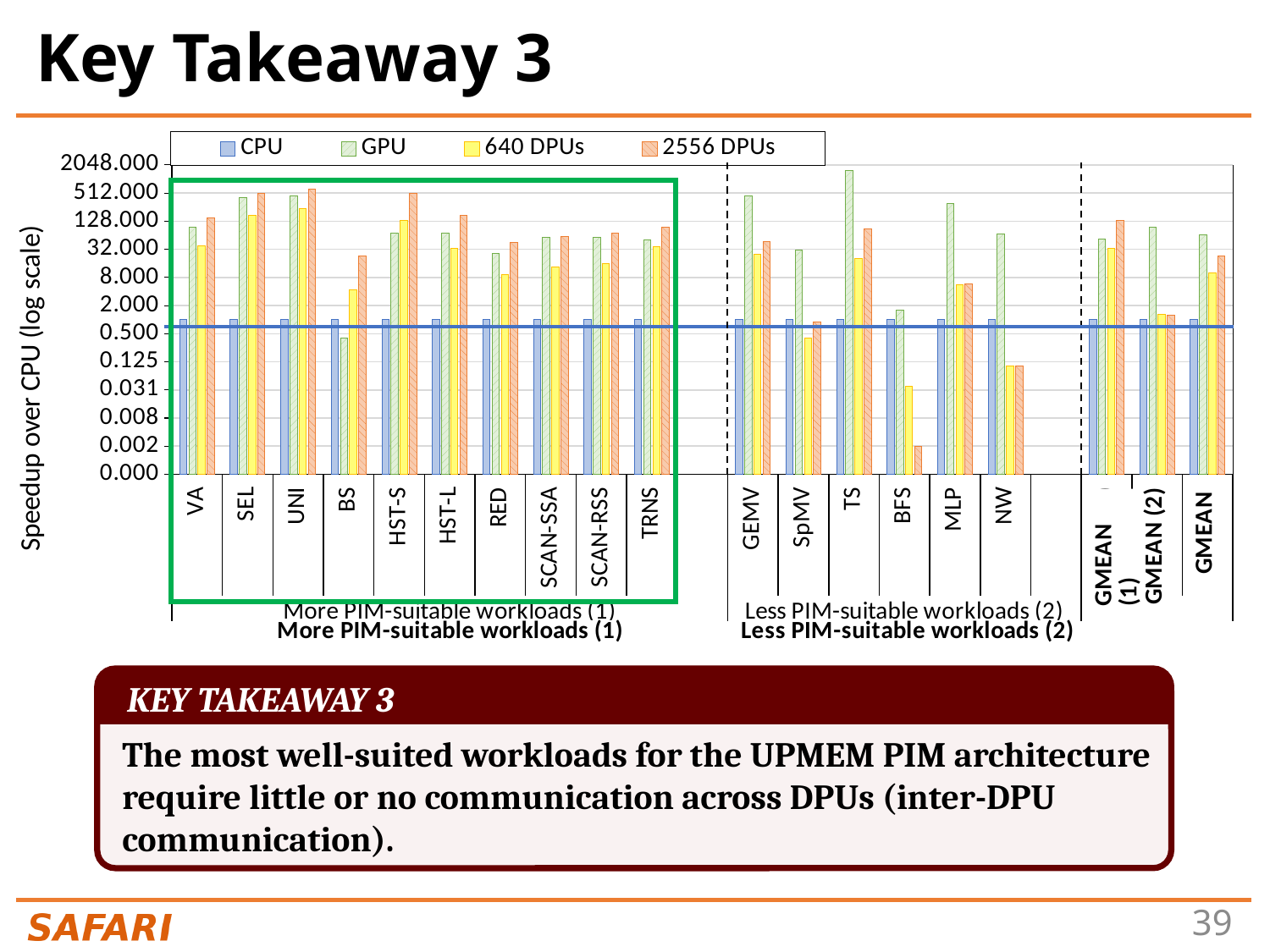
For BS, which series has the highest bar? 2556 DPUs For MLP, which is larger: the GPU value or the 2556 DPUs value? GPU How many series does the chart legend list? 4 How many workload categories (including the GMEAN entries) are plotted along the x axis? 19 Which workload has the highest GPU bar? TS What is the label of the y axis of the chart? Speedup over CPU (log scale) Is the 640 DPUs value for BFS greater or less than 0.125? less What kind of chart is shown on the slide? bar chart Which series does the legend list last? 2556 DPUs Is the GPU value for BS greater or less than 0.500? less Is the 2556 DPUs value for SEL greater or less than 128.000? greater